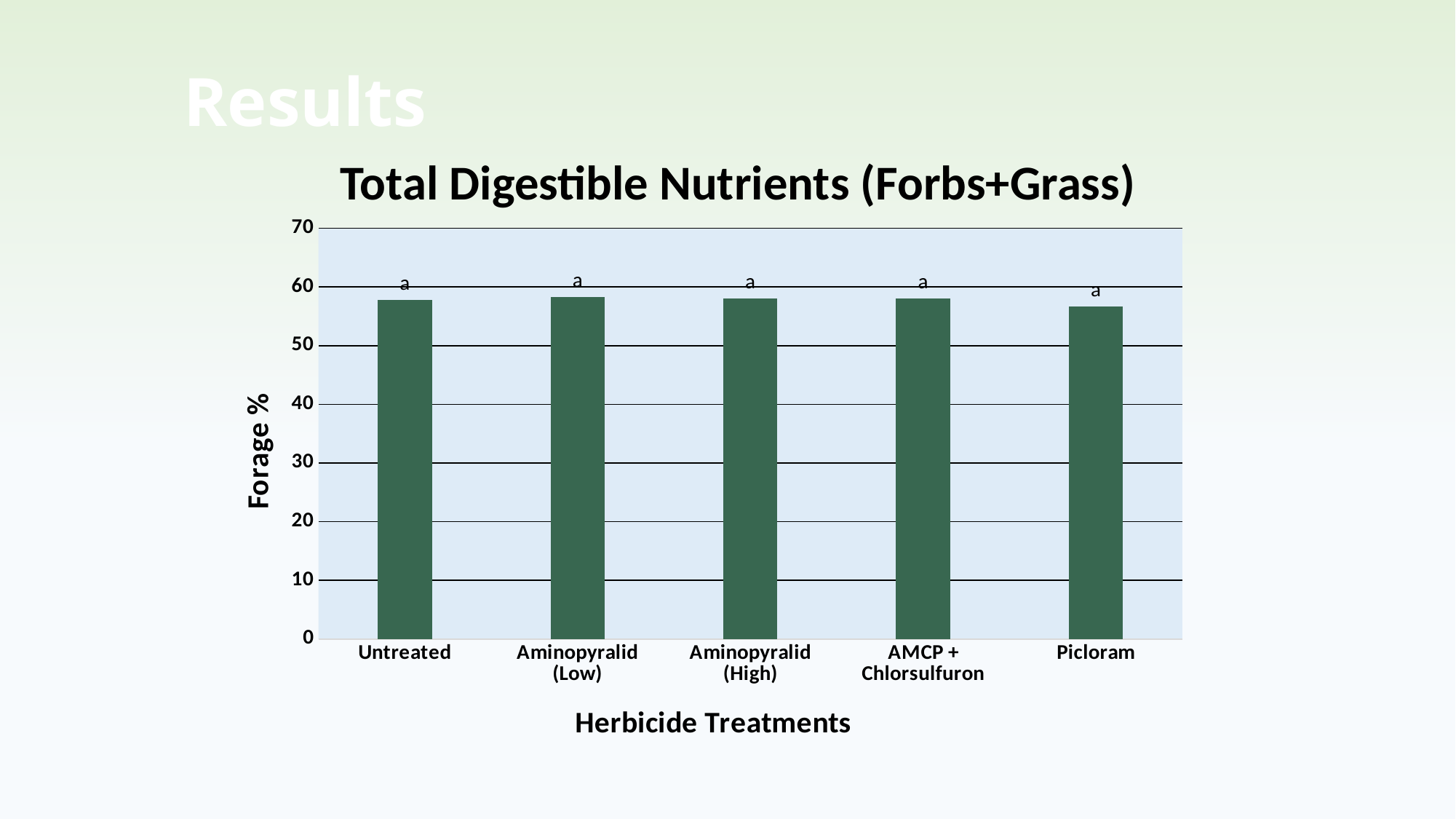
Is the value for Picloram greater or less than 50? greater Is the value for Untreated greater or less than 60? less Is the value for AMCP + Chlorsulfuron greater or less than 50? greater What is the title of the chart? Total Digestible Nutrients (Forbs+Grass) What is the label on the vertical axis of the chart? Forage % What kind of chart is shown on the slide? Bar chart How many herbicide treatment categories are shown in the chart? 5